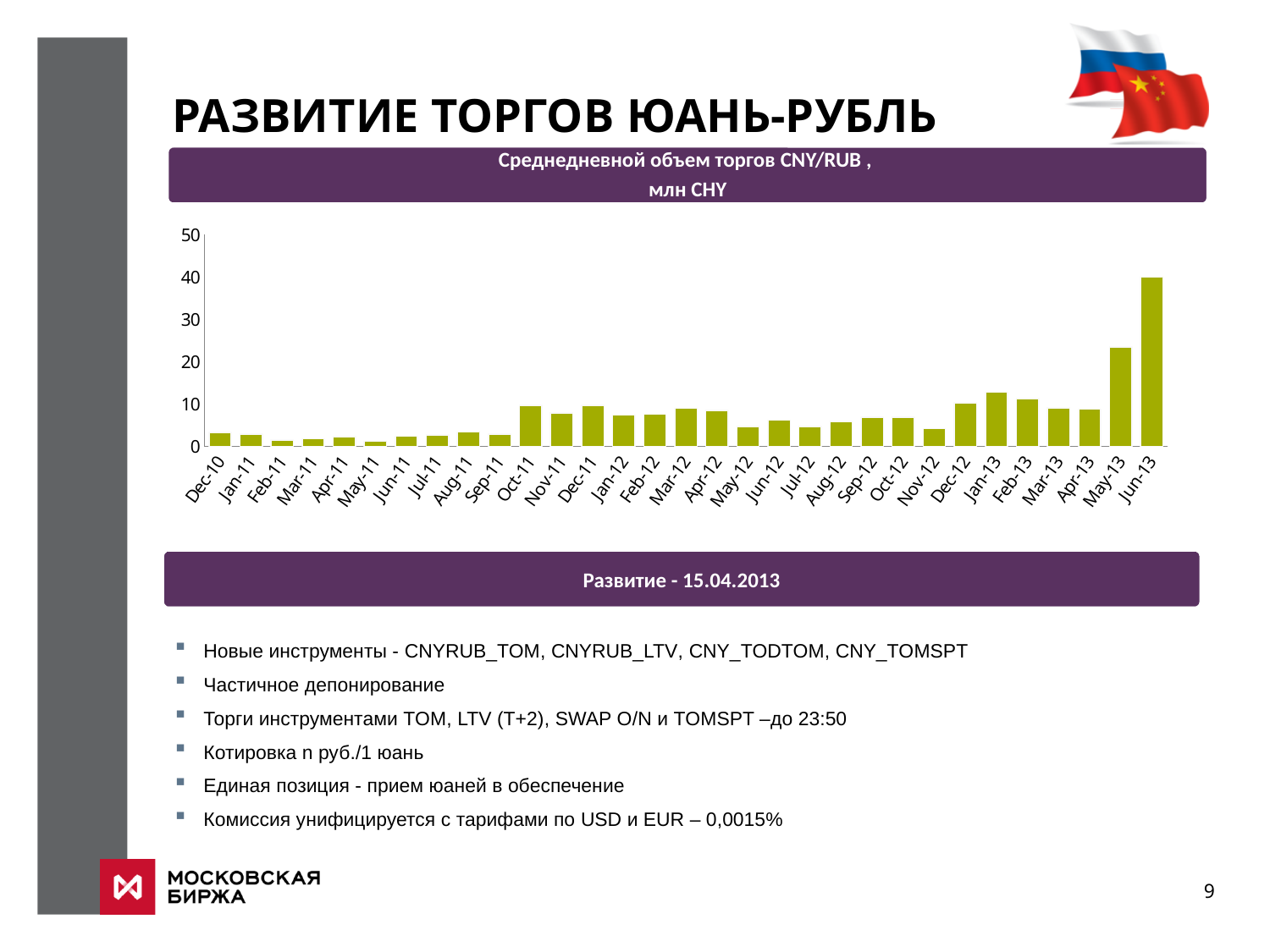
What kind of chart is shown on the slide? bar chart Which month has the highest average daily trading volume? Jun-13 Is the value for Jan-13 greater or less than 10? greater What is the first month shown on the x axis? Dec-10 Which is larger, the value for May-13 or the value for Jun-13? Jun-13 How many months (bars) are plotted in the chart? 31 Which is larger, the value for Sep-11 or the value for Oct-11? Oct-11 Is the value for May-13 greater or less than 20? greater What is the title of the chart? Среднедневной объем торгов CNY/RUB, млн CHY Is the value for Dec-10 greater or less than 10? less Overall, do the values rise or fall from Dec-10 to Jun-13? rise